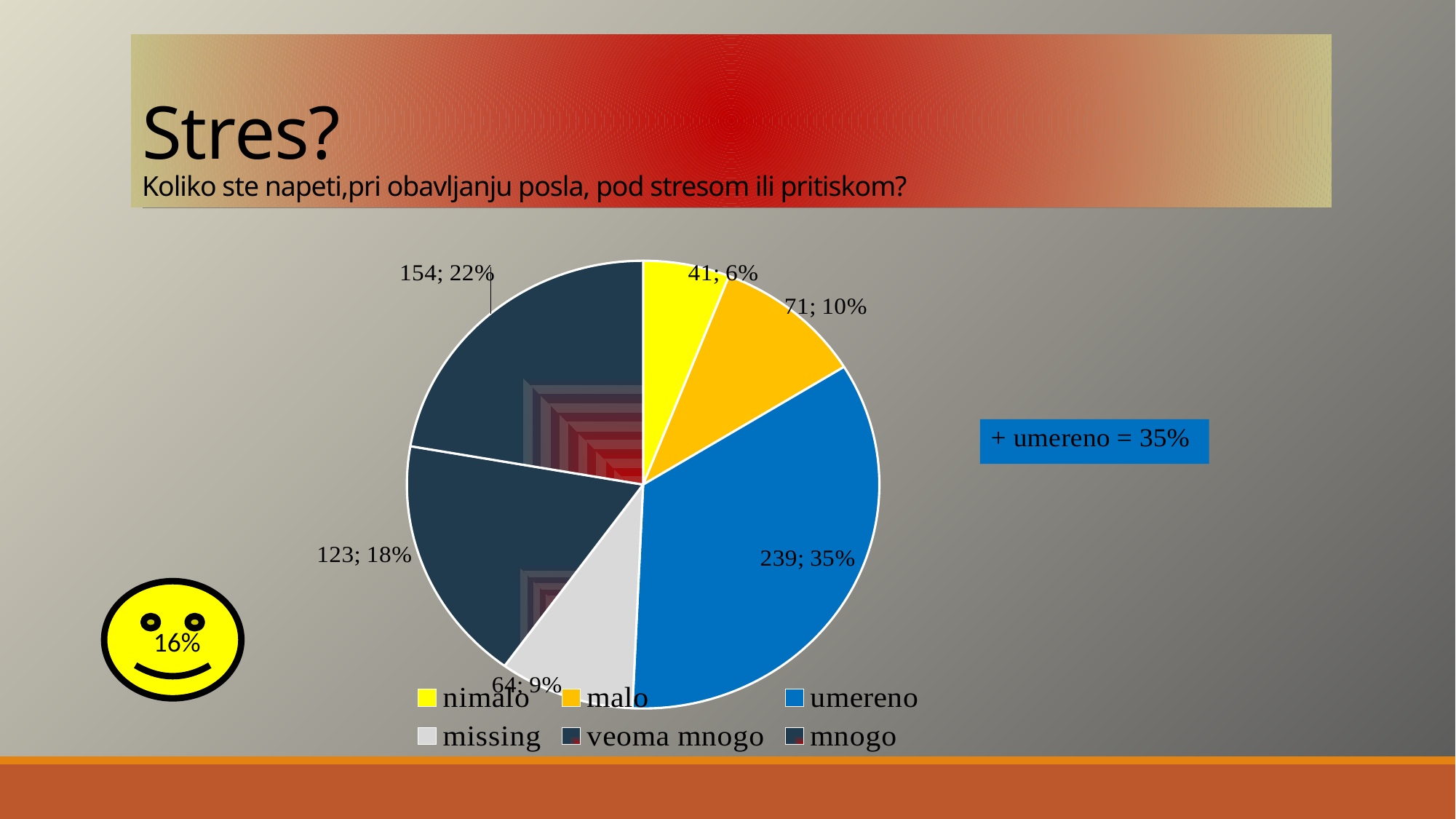
What is the data label shown for the 'malo' slice? 71; 10% What colour is the 'umereno' slice in the pie chart? blue What is the data label shown for the 'missing' slice? 64; 9% Which is larger, the count for 'malo' or the count for 'missing'? malo What is the data label shown for the 'umereno' slice? 239; 35% What is the data label shown for the 'nimalo' slice? 41; 6% How many categories does the legend of the pie chart list? 6 Which category has the smallest slice of the pie? nimalo What is the difference between the counts for 'malo' and 'nimalo'? 30 What kind of chart is shown on the slide? pie chart What share of the pie does the 'umereno' slice represent? 35% Which category has the largest slice of the pie? umereno